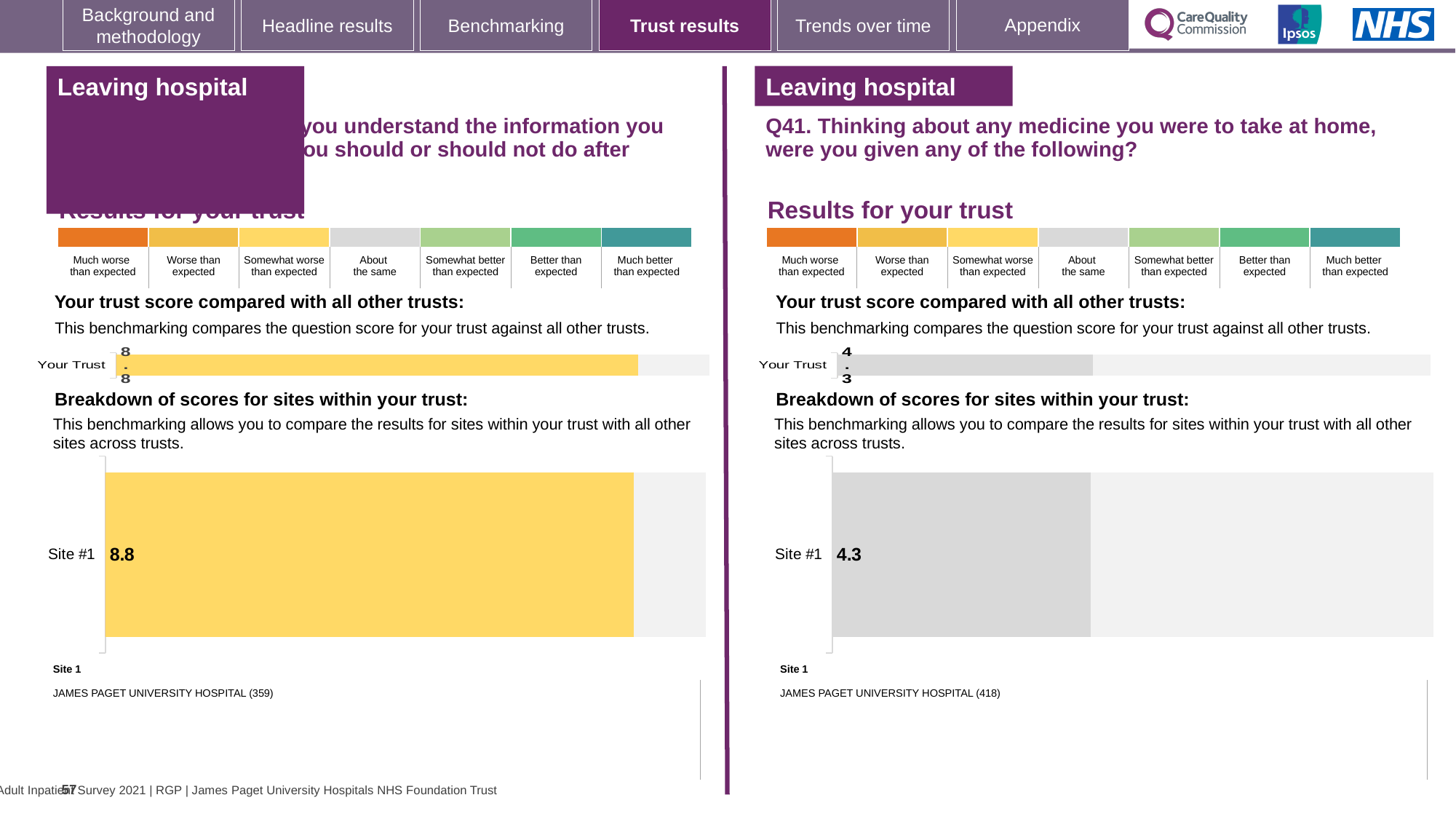
Which benchmarking category does the yellow colour of the 'Your Trust' bar in the left-hand chart correspond to in the colour key? Somewhat worse than expected On the right-hand side of the slide (Q41), what is the 'Your Trust' score shown in the trust benchmarking bar chart? 4.3 How many sites are shown in the left-hand 'Breakdown of scores for sites within your trust' chart? 1 What kind of chart is used to show the Site #1 score in the right-hand (Q41) breakdown section? Bar chart In the right-hand (Q41) 'Breakdown of scores for sites within your trust' chart, what is the score for Site #1? 4.3 Which benchmarking category does the grey colour of the 'Your Trust' bar in the right-hand (Q41) chart correspond to in the colour key? About the same In the left-hand 'Breakdown of scores for sites within your trust' chart, what is the score for Site #1? 8.8 On the left-hand side of the slide, what is the 'Your Trust' score shown in the trust benchmarking bar chart? 8.8 Which is larger: the 'Your Trust' score on the left-hand chart or the 'Your Trust' score on the right-hand (Q41) chart? The left-hand chart (8.8) What is the difference between the Site #1 score in the left-hand breakdown chart and the Site #1 score in the right-hand (Q41) breakdown chart? 4.5 What is the name of the site labelled Site 1 beneath the right-hand (Q41) breakdown chart? JAMES PAGET UNIVERSITY HOSPITAL (418) How many sites are shown in the right-hand (Q41) 'Breakdown of scores for sites within your trust' chart? 1